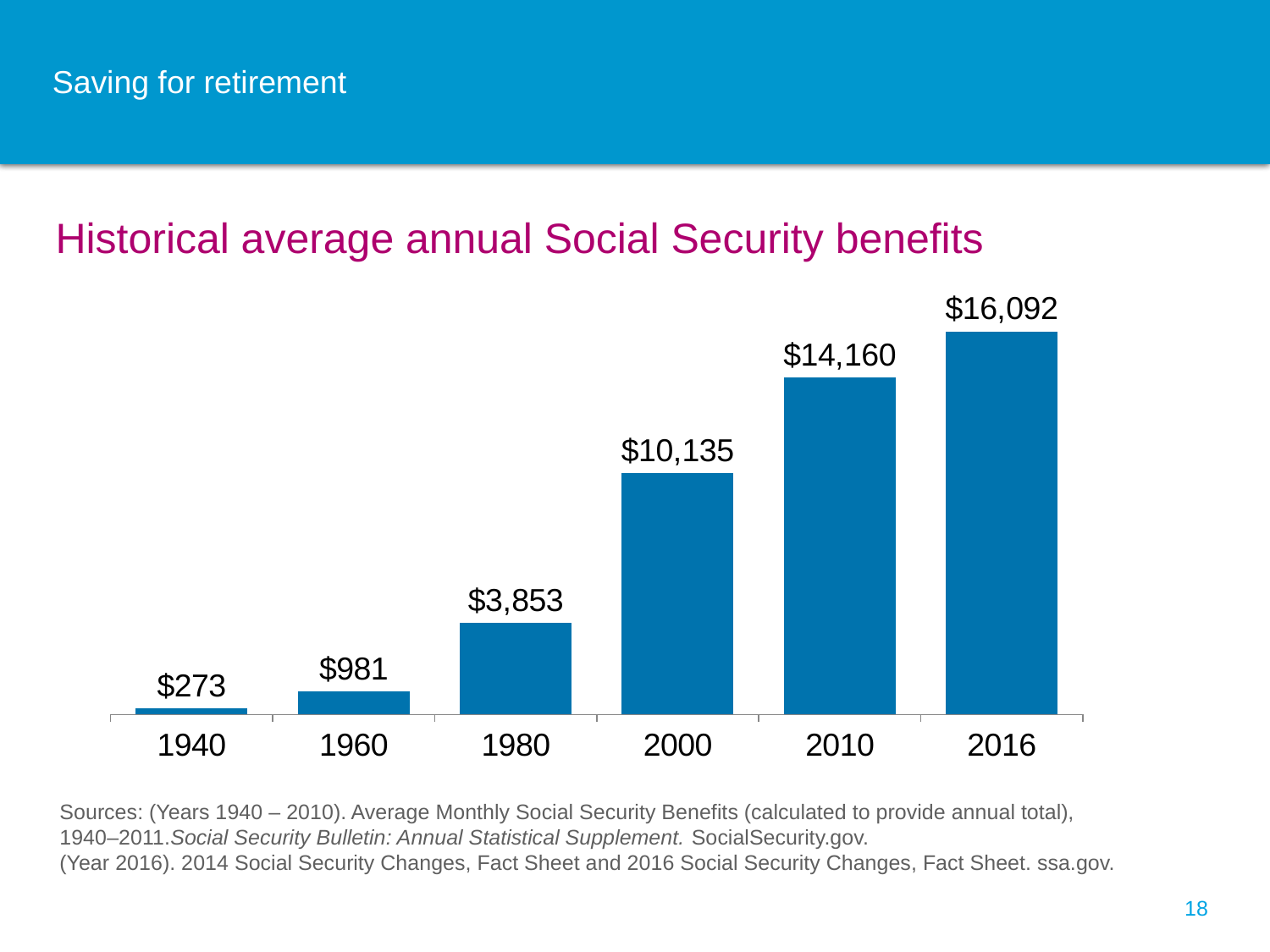
Which year has the highest average annual Social Security benefit? 2016 What is the difference between the 2000 and 1980 values? $6,282 How many years are shown on the x axis of the chart? 6 What is the average annual Social Security benefit shown for 1980? $3,853 What is the difference between the 2016 and 2010 values? $1,932 Do the values rise or fall from 1940 to 2016? Rise What is the average annual Social Security benefit shown for 2010? $14,160 Which is larger, the value for 1960 or the value for 1980? 1980 What is the average annual Social Security benefit shown for 2016? $16,092 What kind of chart is shown on the slide? Bar chart What is the average annual Social Security benefit shown for 1940? $273 Which year has the lowest average annual Social Security benefit? 1940